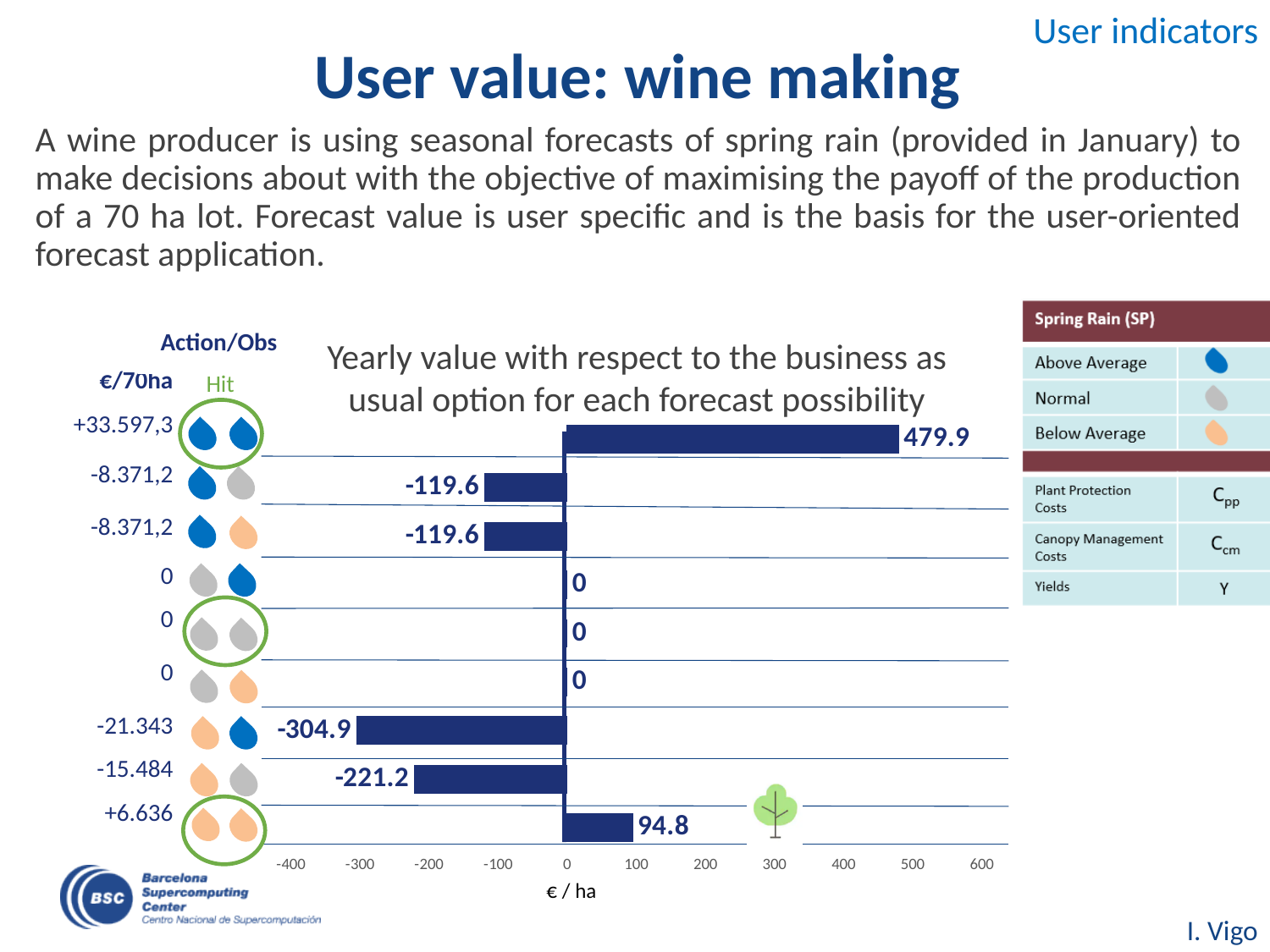
Is the value of the top bar greater or less than 400? greater What is the title of the chart? Yearly value with respect to the business as usual option for each forecast possibility Which bar has the lowest value in the chart? the -21.343 €/70ha row (-304.9) What is the value of the bar corresponding to the -15.484 €/70ha row? -221.2 Which bar has the highest value in the chart? the top bar (479.9) What is the value of the top bar in the chart? 479.9 What is the value of the bottom bar in the chart? 94.8 What is the value of the bar corresponding to the -21.343 €/70ha row? -304.9 What type of chart is shown on the slide? bar chart What is the difference between the highest bar value (479.9) and the bottom bar value (94.8)? 385.1 What is the x-axis label of the chart? € / ha How many bars (forecast possibilities) are plotted in the chart? 9